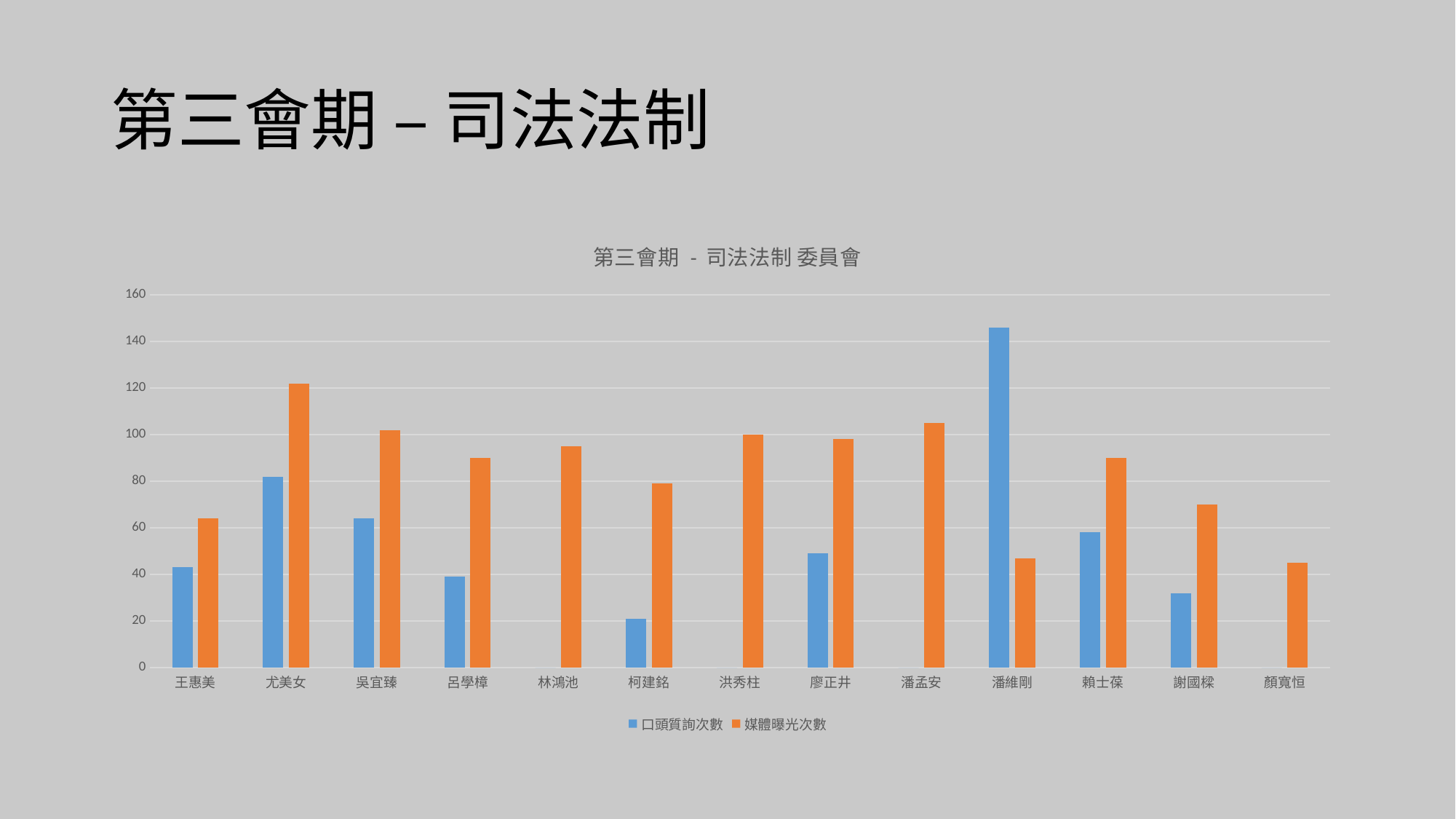
How many series does the legend list? 2 What type of chart is shown on the slide? bar chart For 潘維剛, which is larger: 口頭質詢次數 or 媒體曝光次數? 口頭質詢次數 For 賴士葆, which is larger: 口頭質詢次數 or 媒體曝光次數? 媒體曝光次數 Is the 口頭質詢次數 value for 潘維剛 greater or less than 140? greater How many legislators (categories) are shown on the x axis? 13 Is the 媒體曝光次數 value for 尤美女 greater or less than 100? greater Which legislator has the highest 媒體曝光次數? 尤美女 What is the title of the chart? 第三會期 - 司法法制 委員會 Which legislator has the highest 口頭質詢次數? 潘維剛 Is the 口頭質詢次數 value for 柯建銘 greater or less than 40? less